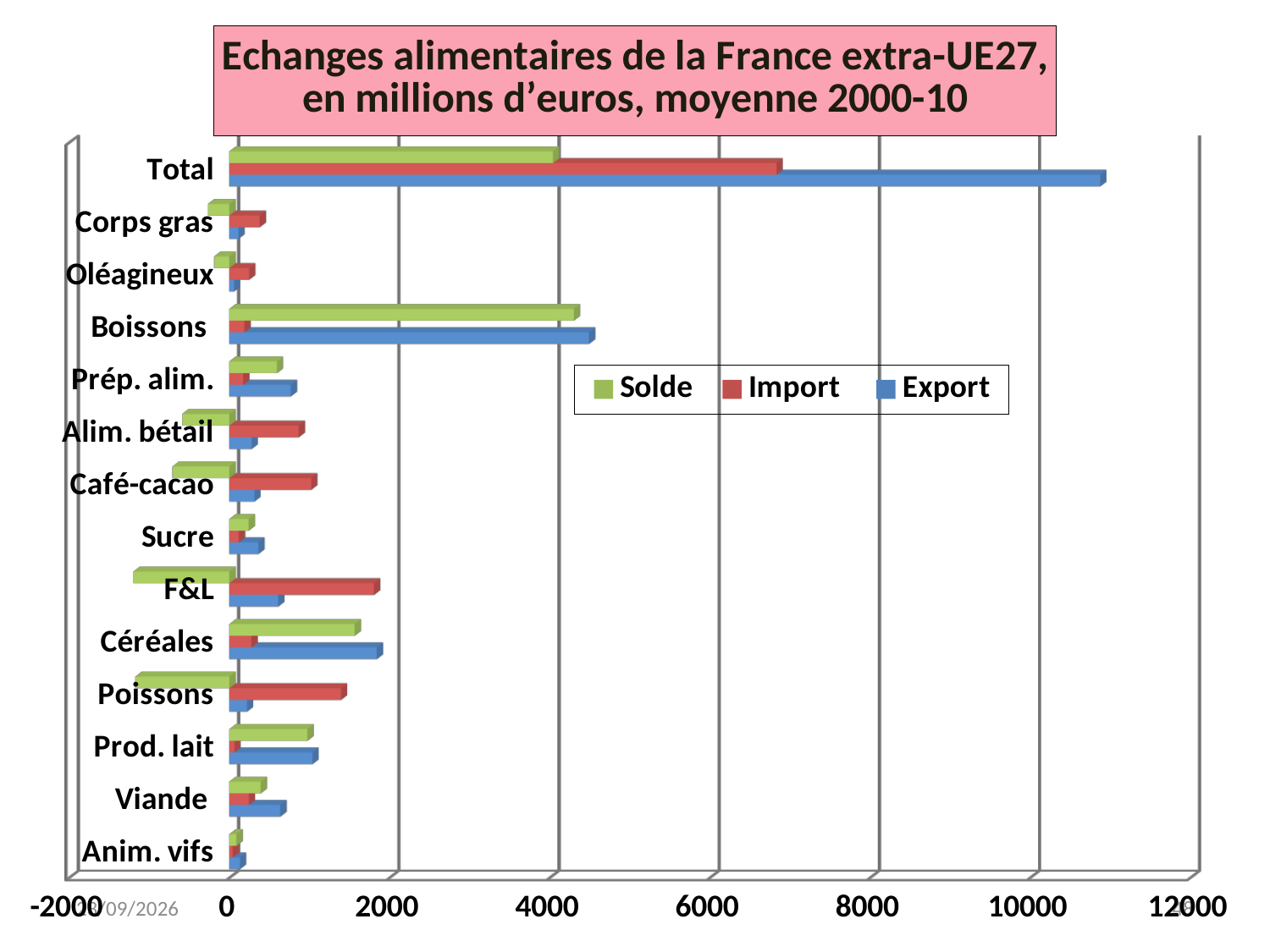
Excluding Total, which category has the highest Export value? Boissons Is the Export value for Total greater or less than 10000? greater Is the Import value for F&L greater or less than 2000? less Which has the larger Export value, Boissons or Céréales? Boissons How many categories are plotted on the chart? 14 Is the Export value for Boissons greater or less than 4000? greater Which has the larger Import value, F&L or Poissons? F&L Which category has the lowest (most negative) Solde value? F&L Which series are listed in the legend? Solde, Import, Export What kind of chart is shown on the slide? Bar chart How many series does the legend list? 3